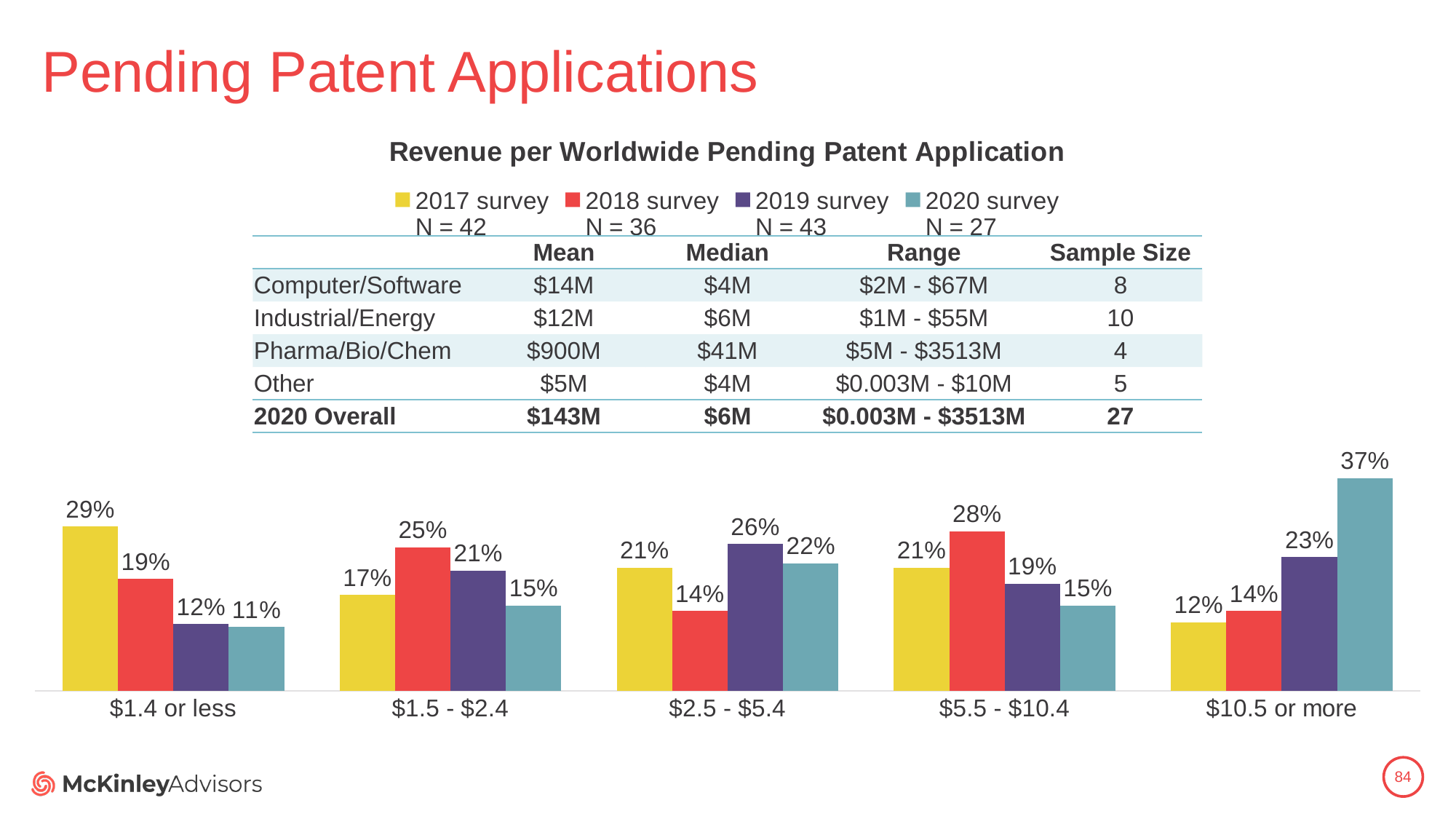
In the "$1.5 - $2.4" category, which is larger: the 2018 survey value or the 2020 survey value? 2018 survey What is the value for the 2018 survey in the "$5.5 - $10.4" category? 28% Which category has the highest value for the 2020 survey? $10.5 or more What is the value for the 2019 survey in the "$2.5 - $5.4" category? 26% What is the difference between the 2017 survey and 2020 survey values in the "$1.4 or less" category? 18% How many revenue categories are shown on the x axis of the chart? 5 What is the value for the 2020 survey in the "$10.5 or more" category? 37% What is the sample size (N) for the 2020 survey shown in the legend? 27 What is the value for the 2017 survey in the "$1.4 or less" category? 29% What kind of chart is shown on the slide? bar chart How many series does the chart legend list? 4 Which category has the lowest value for the 2017 survey? $10.5 or more